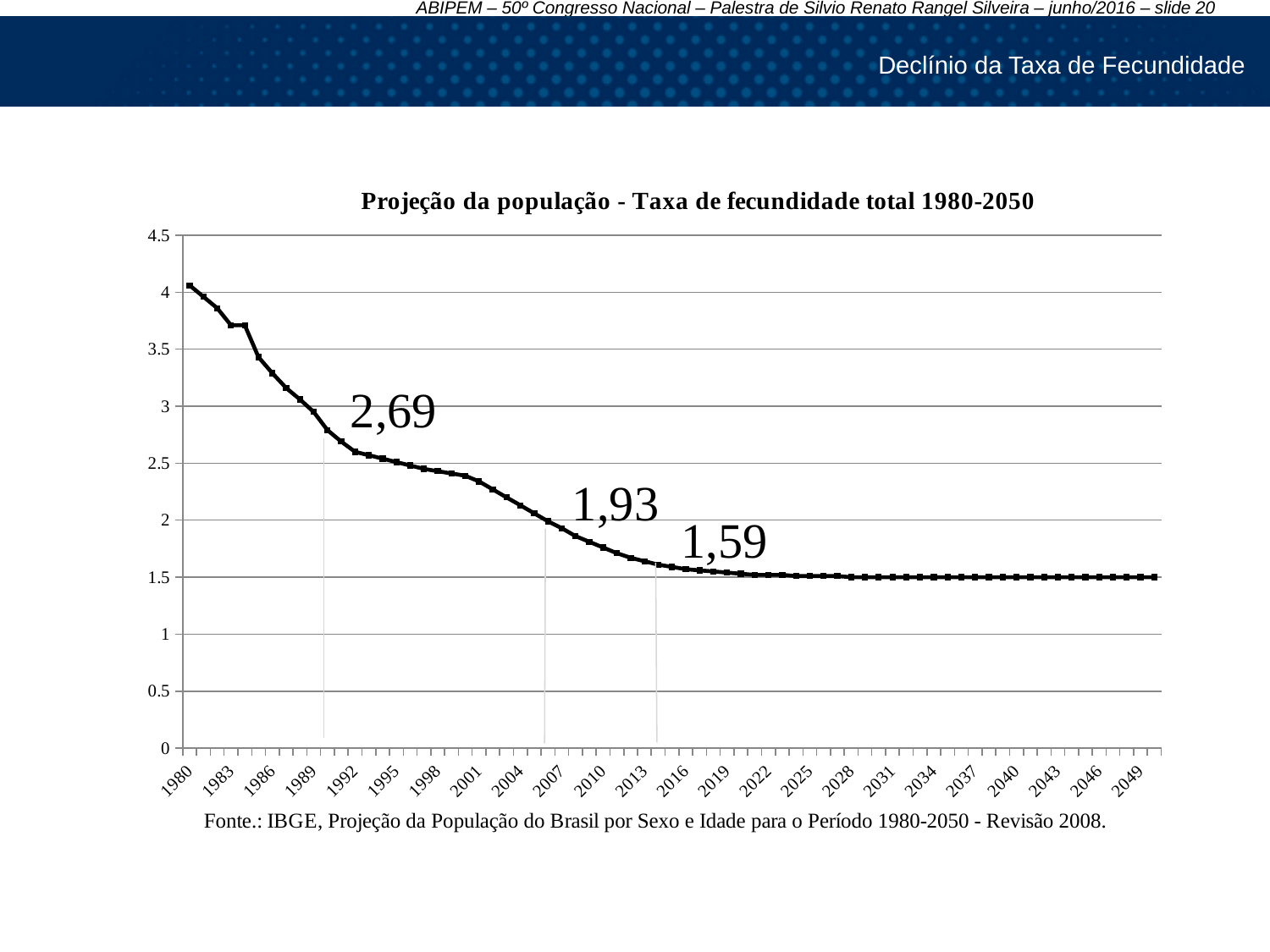
What kind of chart is shown on the slide? line chart Does the fertility rate rise or fall from 1980 to 2049 along the x axis? fall What is the largest data label printed on the line? 2,69 What is the difference between the data labels 2,69 and 1,93? 0,76 What is the difference between the data labels 1,93 and 1,59? 0,34 What is the highest value shown on the y axis? 4.5 What is the smallest data label printed on the line? 1,59 Is the value for 1986 greater or less than 3? greater What is the title of the chart? Projeção da população - Taxa de fecundidade total 1980-2050 Is the value for 2049 greater or less than 2? less Is the value for 2001 greater or less than 2? greater How many year labels are shown on the x axis? 24